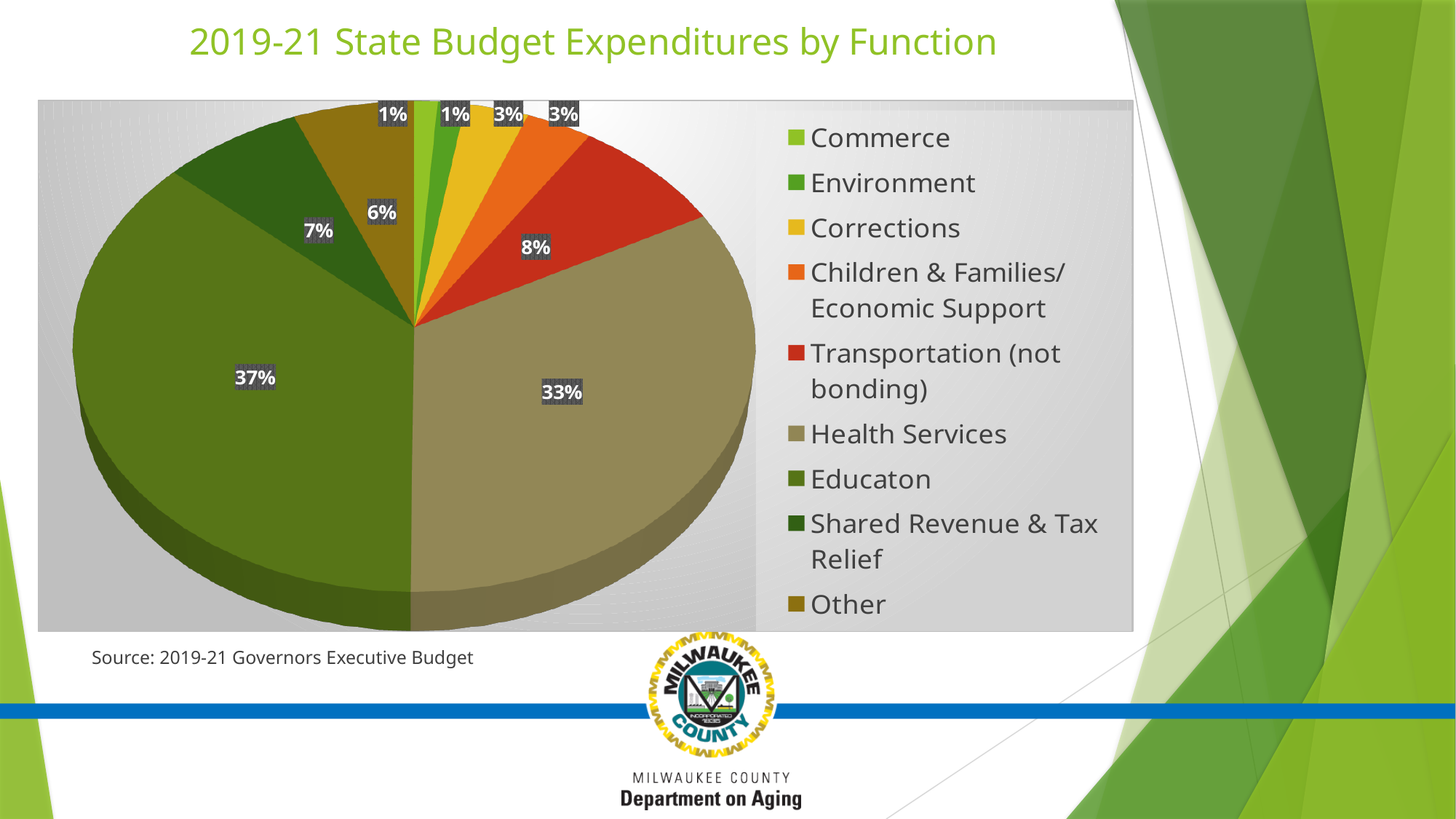
What percentage of expenditures is for Transportation (not bonding)? 8% What kind of chart is shown on the slide? Pie chart Which is larger, the share for Health Services or the share for Education? Education What share of the pie is labelled Other? 6% By how many percentage points does Education exceed Health Services? 4 percentage points Which function has the largest share of expenditures? Education What share of 2019-21 state budget expenditures goes to Health Services? 33% What percentage of expenditures goes to Shared Revenue & Tax Relief? 7% What is the title of the chart? 2019-21 State Budget Expenditures by Function What source is cited below the chart? 2019-21 Governors Executive Budget How many categories does the legend list? 9 What is the combined share of Education and Health Services? 70%